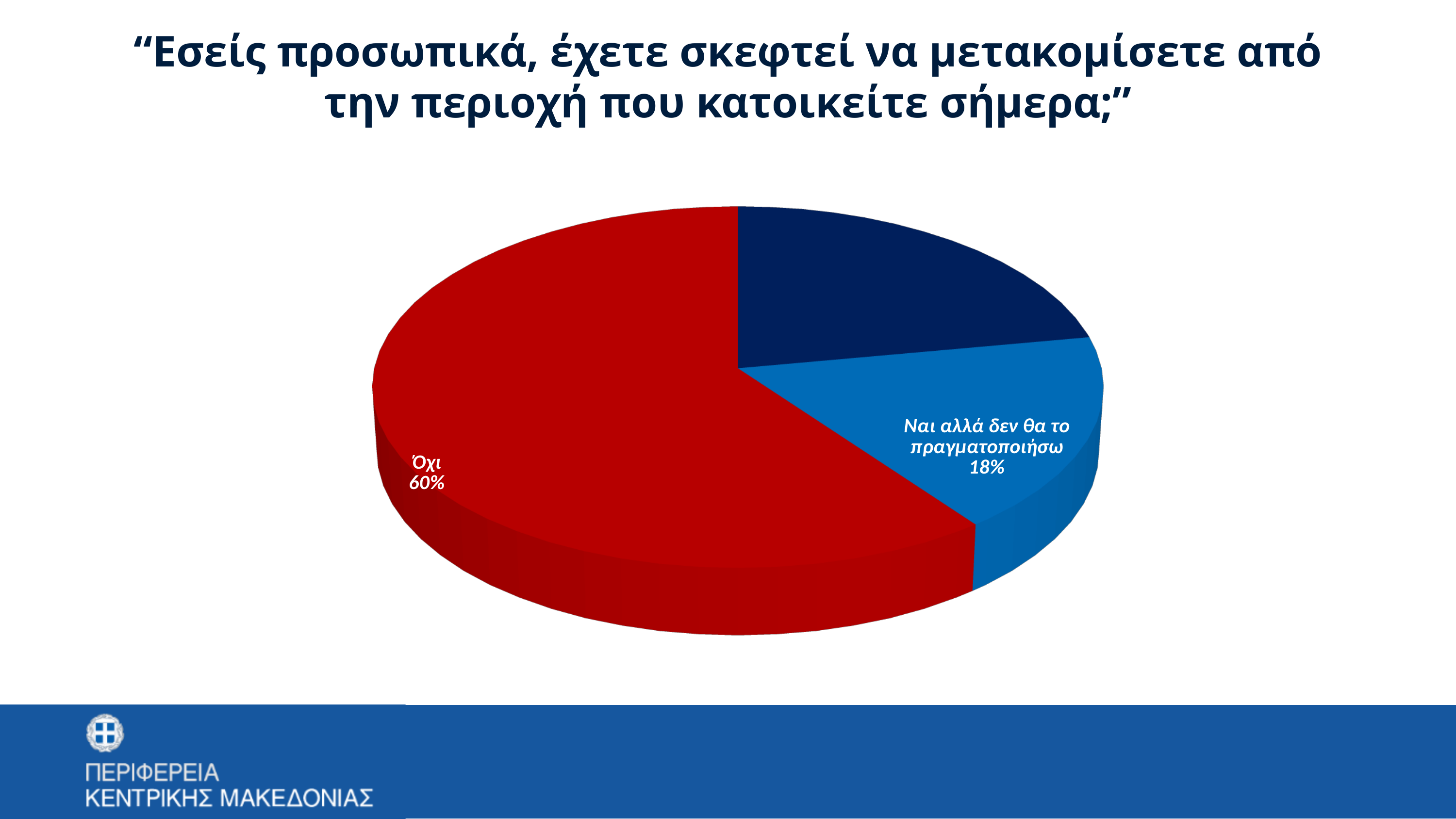
How many slices does the pie chart have? 3 What percentage of respondents answered "Όχι"? 60% What colour is the "Όχι" slice of the pie chart? red What question is shown as the title above the pie chart? "Εσείς προσωπικά, έχετε σκεφτεί να μετακομίσετε από την περιοχή που κατοικείτε σήμερα;" What share of the pie does the "Όχι" slice represent? 60% What kind of chart is shown on the slide? pie chart What percentage of respondents answered "Ναι αλλά δεν θα το πραγματοποιήσω"? 18% By how many percentage points does "Όχι" exceed "Ναι αλλά δεν θα το πραγματοποιήσω"? 42 percentage points Is the share for "Όχι" greater or less than 50%? greater Which is larger: the share for "Όχι" or the share for "Ναι αλλά δεν θα το πραγματοποιήσω"? Όχι Which labelled answer has the largest share of the pie? Όχι